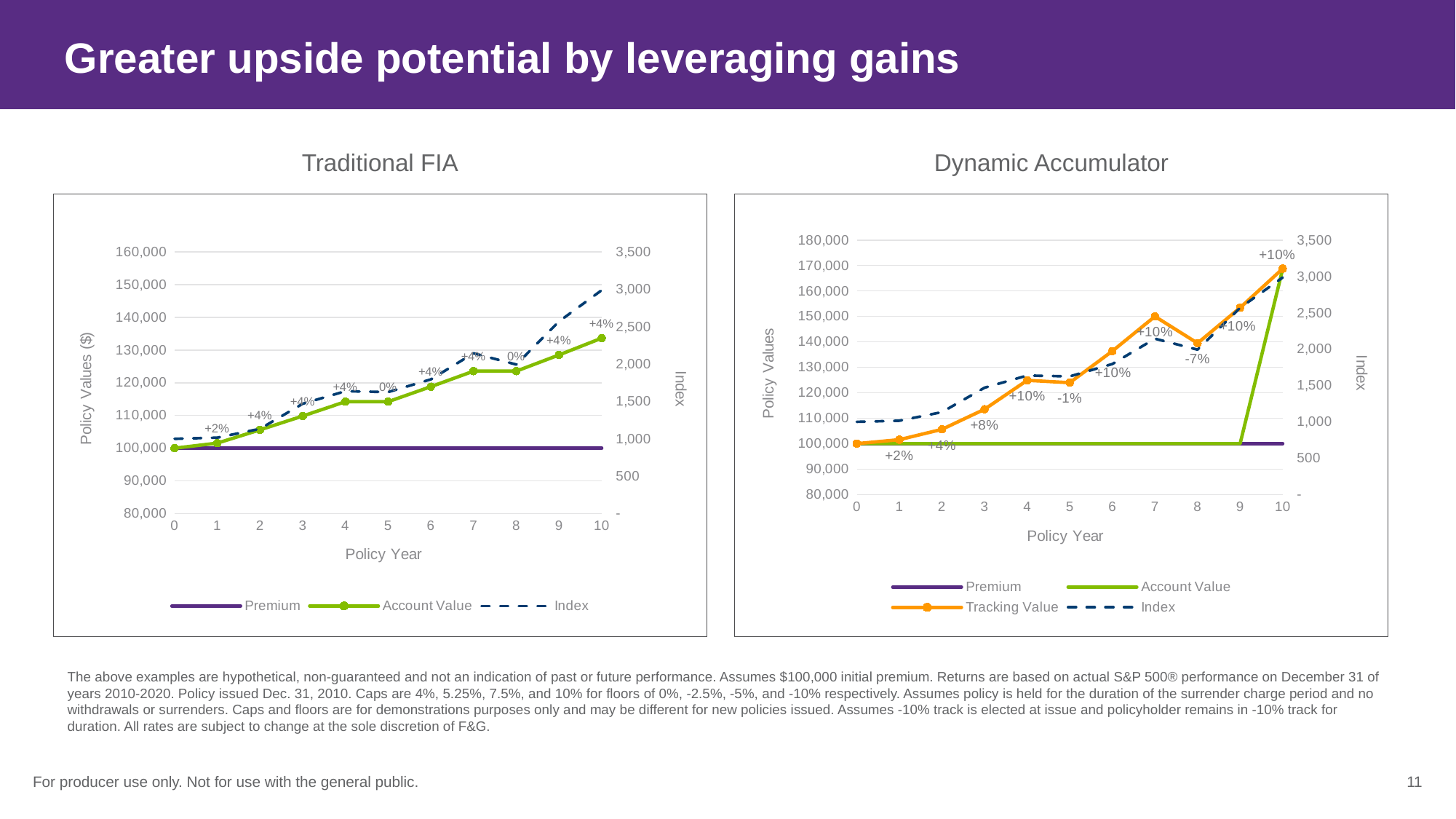
How many series does the legend of the Dynamic Accumulator chart list? 4 In the Traditional FIA chart, is the Account Value at policy year 10 greater or less than 130,000? greater How many policy years are plotted on the x axis of the Dynamic Accumulator chart? 11 In the Dynamic Accumulator chart, what percentage label is shown at policy year 8? -7% In the Dynamic Accumulator chart, what percentage label is shown at policy year 3? +8% What type of chart is the Traditional FIA chart? line chart How many series does the legend of the Traditional FIA chart list? 3 In the Traditional FIA chart, does the Account Value generally rise or fall from policy year 0 to policy year 10? rise In the Traditional FIA chart, what percentage label is shown at policy year 5? 0% In the Traditional FIA chart, what percentage label is shown at policy year 1? +2% In the Dynamic Accumulator chart, what is the value of the Premium series across the policy years? 100,000 In the Dynamic Accumulator chart, is the Account Value at policy year 10 greater or less than 160,000? greater